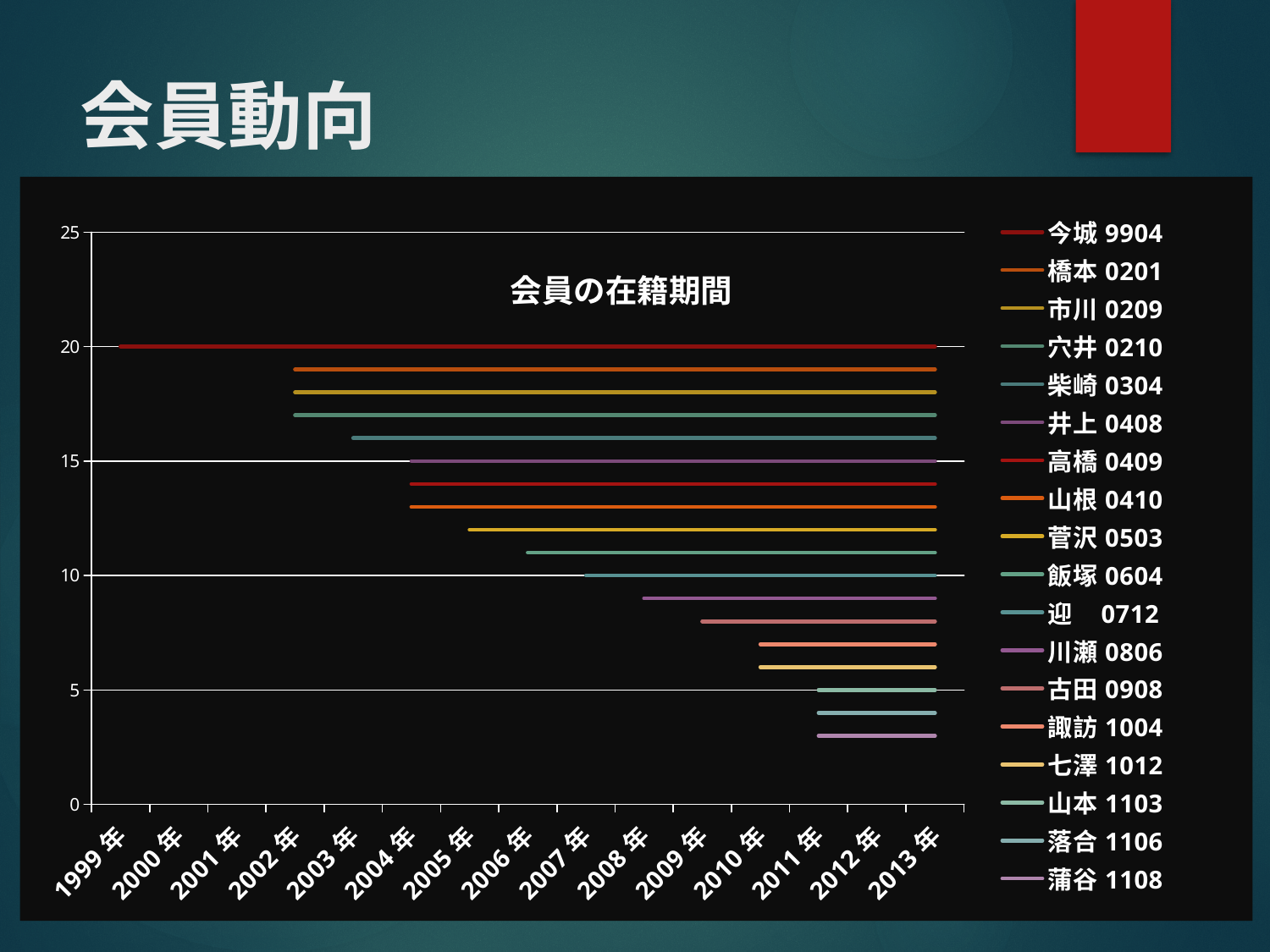
At what y-axis value does the line for 井上 0408 lie? 15 Which series has the lowest line on the chart? 蒲谷 1108 Is the line for 蒲谷 1108 greater or less than 5 on the y axis? less Which series starts earliest on the x axis? 今城 9904 At what y-axis value does the line for 迎 0712 lie? 10 How many year labels are shown on the x axis? 15 At what y-axis value does the line for 今城 9904 lie? 20 How many series does the legend list? 18 Which series has the highest line on the chart? 今城 9904 What kind of chart is shown on the slide? line chart What is the title of the chart? 会員の在籍期間 At what y-axis value does the line for 山本 1103 lie? 5